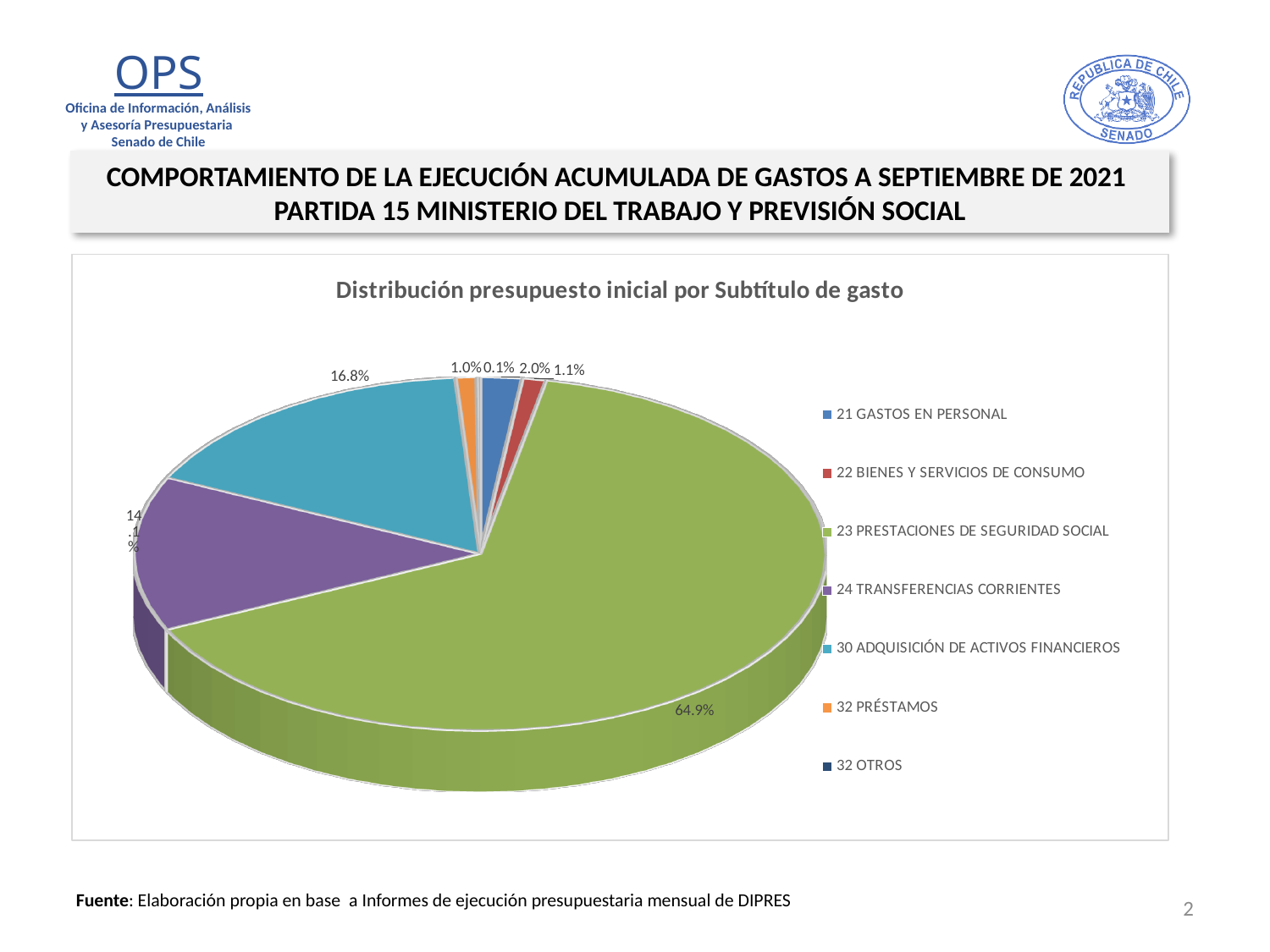
What type of chart is shown on the slide? Pie chart What percentage is shown for 30 ADQUISICIÓN DE ACTIVOS FINANCIEROS? 16.8% What share of the initial budget goes to 23 PRESTACIONES DE SEGURIDAD SOCIAL? 64.9% What percentage is shown for 21 GASTOS EN PERSONAL? 2.0% What percentage is shown for 22 BIENES Y SERVICIOS DE CONSUMO? 1.1% What is the title of the chart? Distribución presupuesto inicial por Subtítulo de gasto How many categories does the legend of the pie chart list? 7 Which subtítulo has the smallest share of the initial budget? 32 OTROS What percentage is shown for 24 TRANSFERENCIAS CORRIENTES? 14.1% Which subtítulo has the largest share of the initial budget? 23 PRESTACIONES DE SEGURIDAD SOCIAL Which has a larger share, 21 GASTOS EN PERSONAL or 22 BIENES Y SERVICIOS DE CONSUMO? 21 GASTOS EN PERSONAL What is the difference in percentage points between 30 ADQUISICIÓN DE ACTIVOS FINANCIEROS and 24 TRANSFERENCIAS CORRIENTES? 2.7